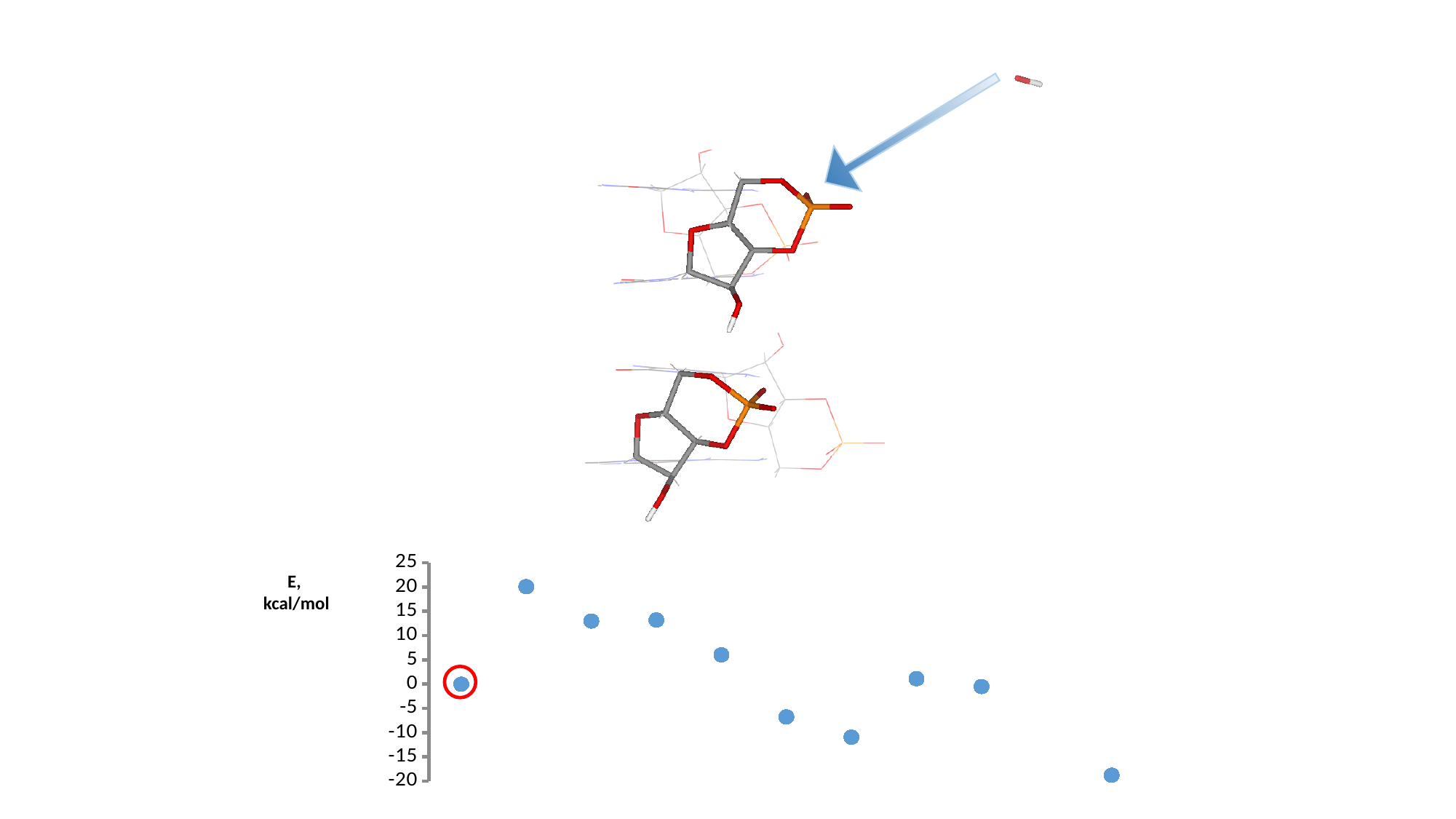
Is the value of the rightmost point greater or less than -10? less What is the maximum value shown on the vertical axis? 25 What is the label of the vertical axis of the chart? E, kcal/mol Is the value of the second point from the left greater or less than 15? greater Is the lowest point in the chart greater or less than -15? less Which point is higher: the second point from the left or the rightmost point? the second point from the left What kind of chart is shown at the bottom of the slide? scatter chart Do the plotted values generally rise or fall from left to right? fall How many data points are plotted in the chart? 10 What value does the point circled in red have on the vertical axis? 0